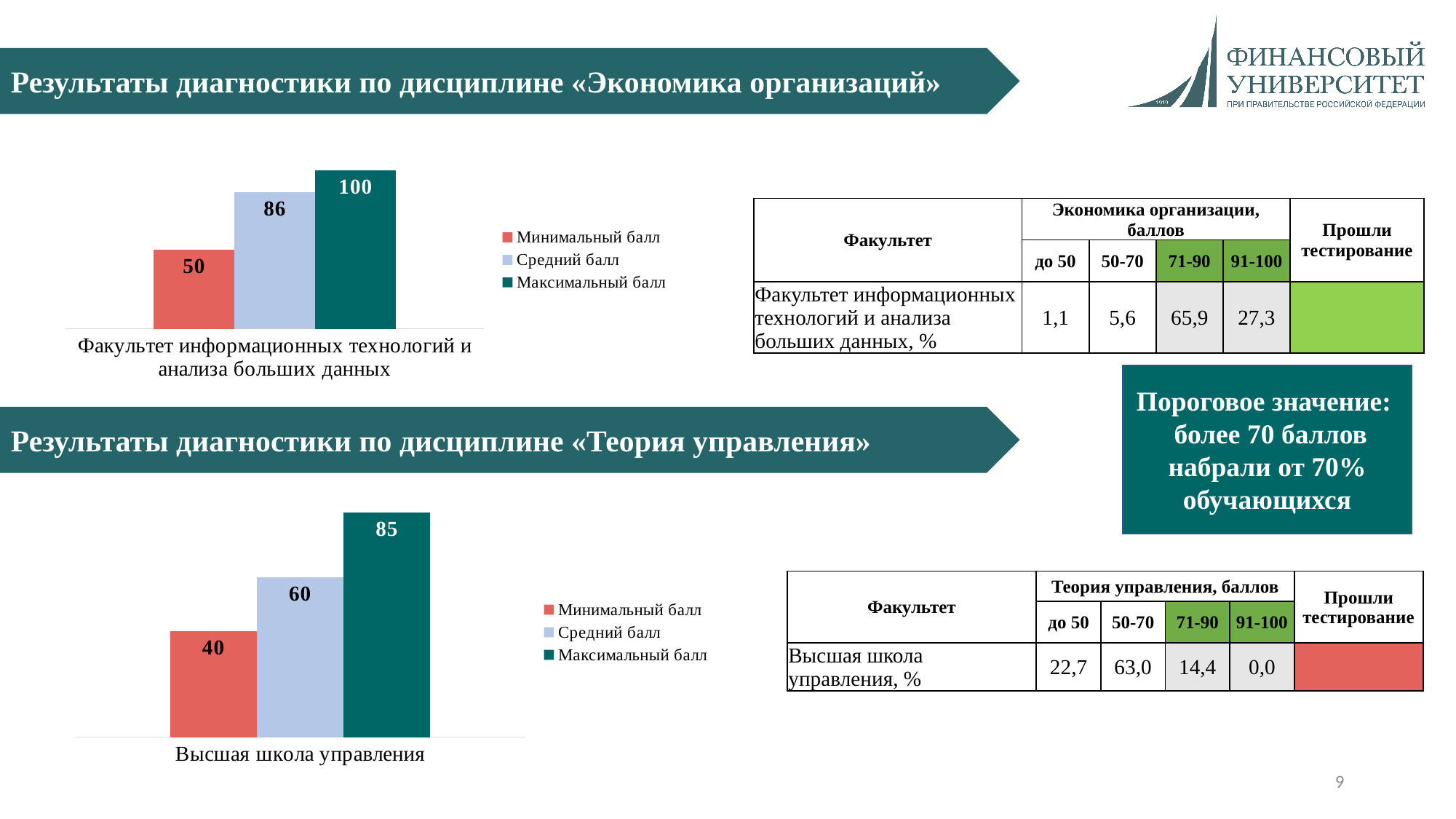
In the bottom chart, which series has the lowest value? Минимальный балл In the top chart, what is the difference between Максимальный балл and Минимальный балл? 50 In the top chart, what is the value of Минимальный балл? 50 How many series does the legend of the bottom chart list? 3 Which is larger: Средний балл in the top chart or Средний балл in the bottom chart? Средний балл in the top chart In the bottom chart, what is the value of Средний балл for Высшая школа управления? 60 In the top chart, what is the value of Средний балл for Факультет информационных технологий и анализа больших данных? 86 In the bottom chart, what is the difference between Средний балл and Минимальный балл? 20 In the top chart, which colour represents Максимальный балл? Dark teal What type of chart is the top chart? Bar chart In the bottom chart, what is the value of Максимальный балл? 85 In the top chart, what is the value of Максимальный балл? 100